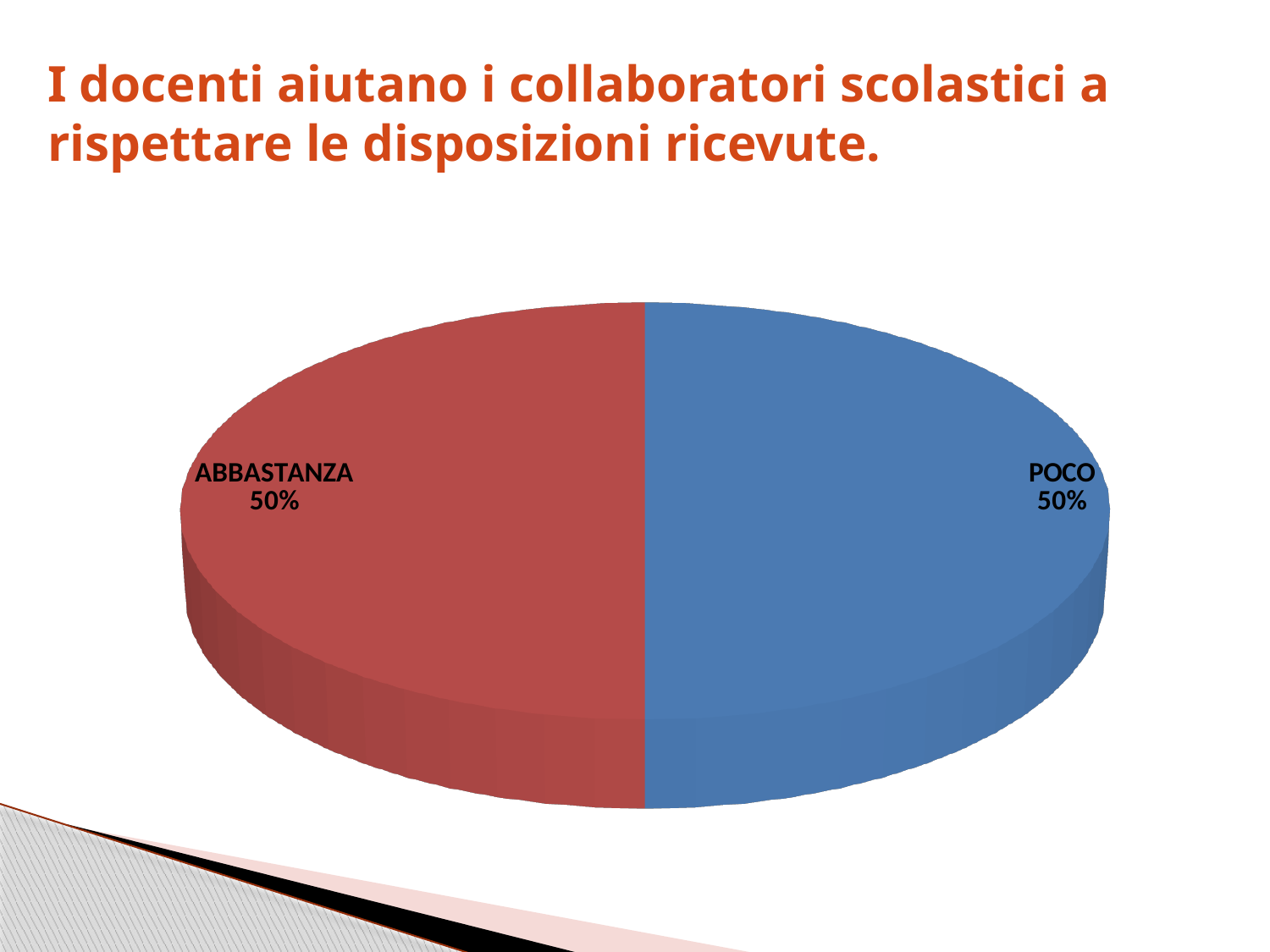
What kind of chart is shown on the slide? pie chart What share of the pie does the POCO slice represent? 50% What is the difference between the ABBASTANZA and POCO shares? 0% What is the combined share of the ABBASTANZA and POCO slices? 100% Is the share for ABBASTANZA greater or less than 75%? less Which slice is shown in blue? POCO Is the share for POCO greater or less than 25%? greater Which slice is shown in red? ABBASTANZA What share of the pie does the ABBASTANZA slice represent? 50% How many slices does the pie chart have? 2